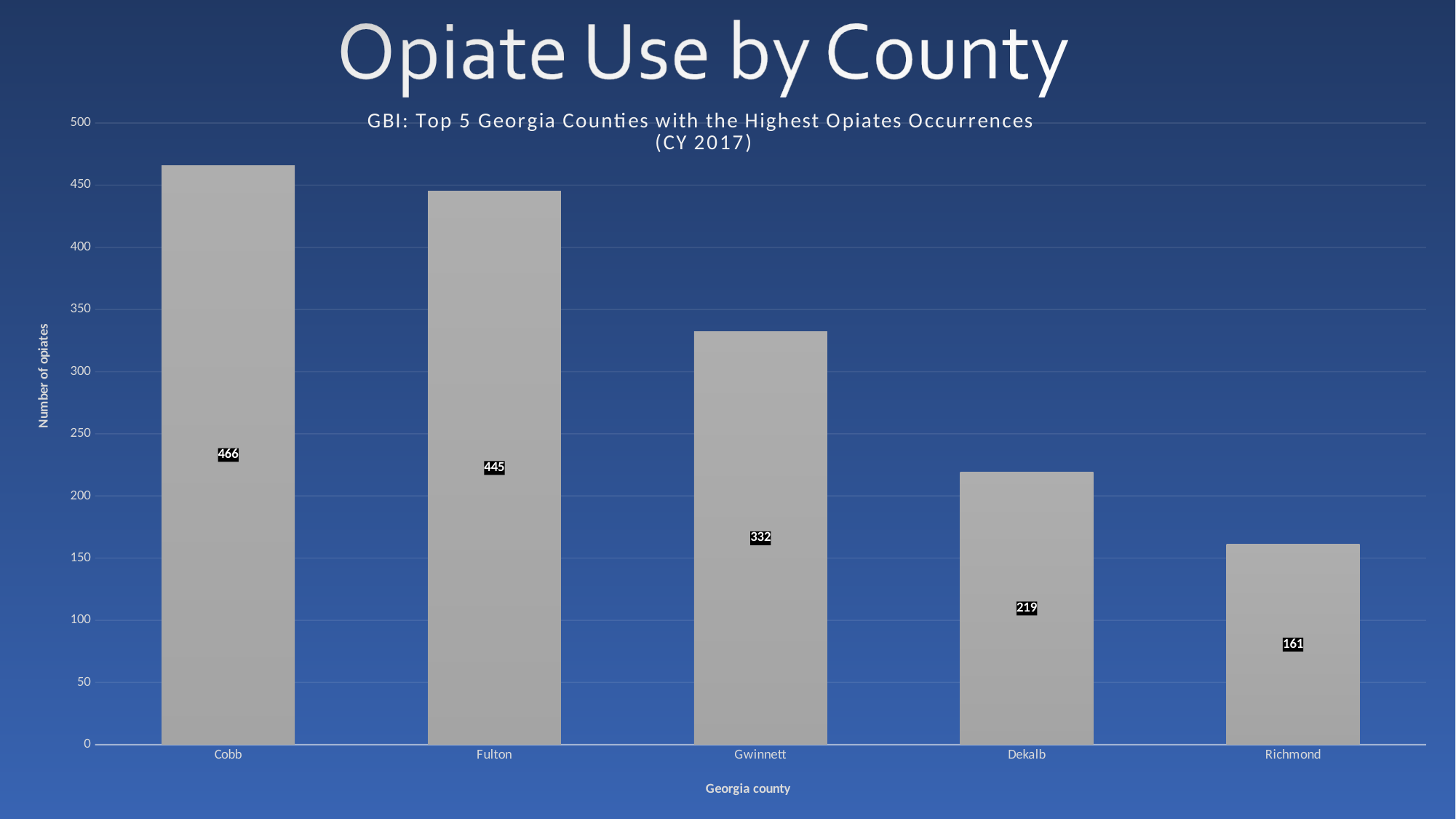
Which county has the highest number of opiates? Cobb What is the difference between the values for Cobb and Fulton? 21 What is the label of the vertical axis? Number of opiates What is the difference between the values for Gwinnett and Dekalb? 113 What is the number of opiates for Richmond county? 161 Which county has a larger value, Dekalb or Richmond? Dekalb What is the number of opiates for Cobb county? 466 What kind of chart is shown on the slide? Bar chart What is the number of opiates for Gwinnett county? 332 Is the value for Fulton greater or less than 400? greater How many counties are shown in the chart? 5 Which county has the lowest number of opiates? Richmond